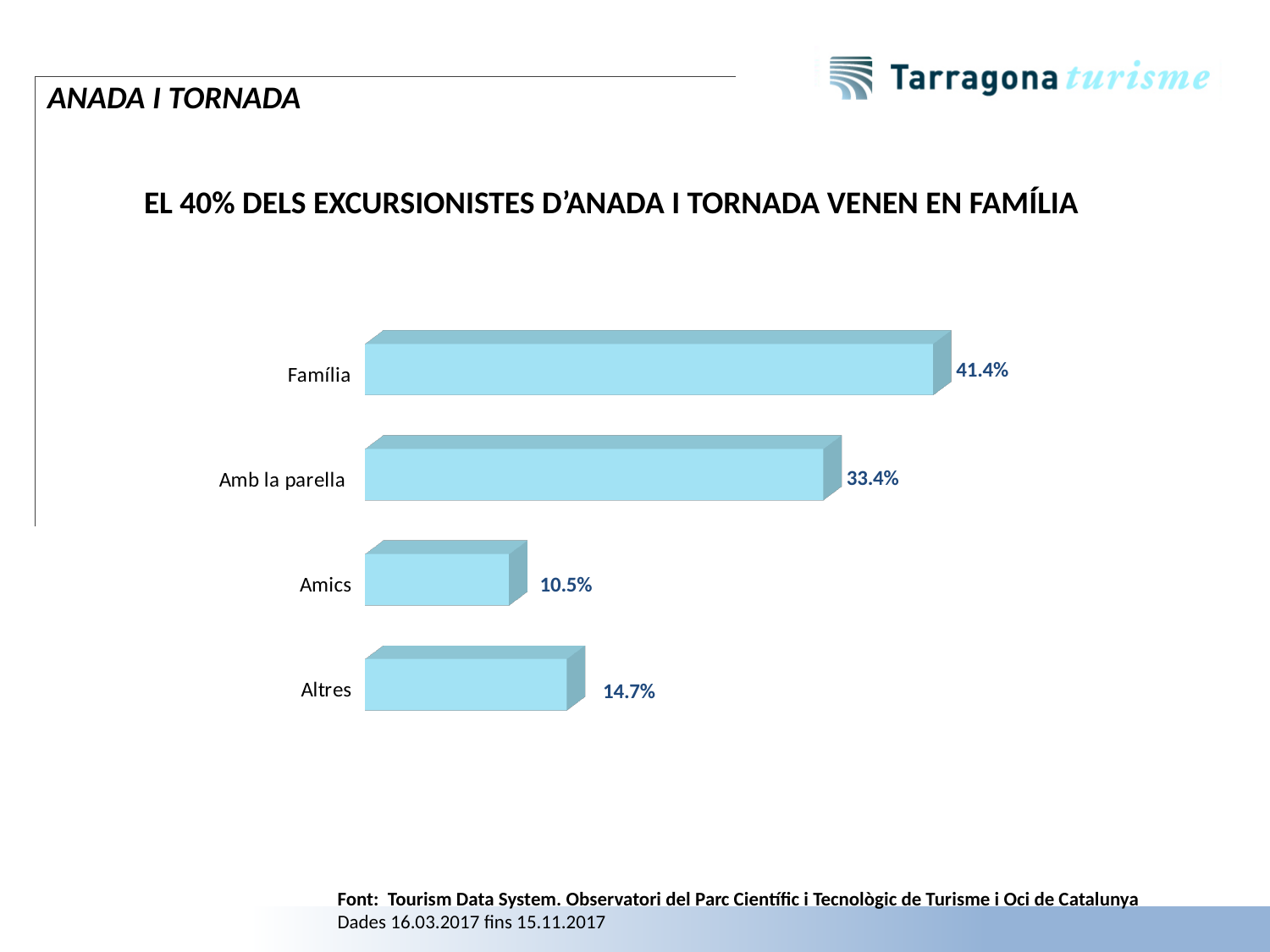
What is the value for Amics? 10.5% Which category has the highest value? Família What is the value for Altres? 14.7% What is the difference between the values for Família and Amb la parella? 8.0% Which is larger, the value for Altres or the value for Amics? Altres What is the value for Família? 41.4% What is the difference between the values for Altres and Amics? 4.2% What is the value for Amb la parella? 33.4% How many categories are shown in the chart? 4 What kind of chart is shown on the slide? Bar chart Which category has the lowest value? Amics What is the title text above the chart? EL 40% DELS EXCURSIONISTES D'ANADA I TORNADA VENEN EN FAMÍLIA